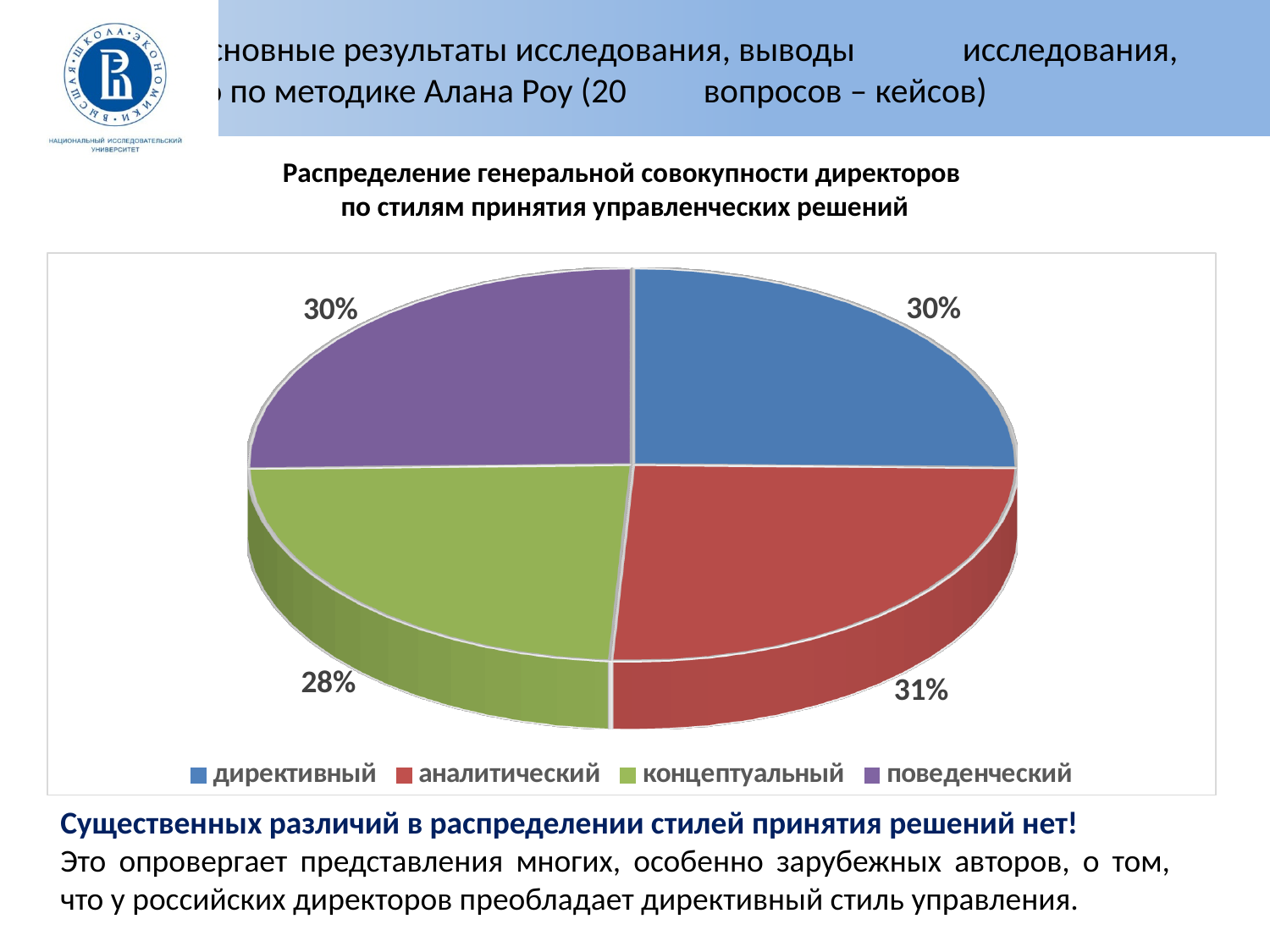
How many slices does the pie chart have? 4 What type of chart is shown on the slide? pie chart Which decision-making style has the smallest share in the pie chart? концептуальный How many entries does the chart legend list? 4 What percentage is shown for the концептуальный style? 28% Which decision-making style has the largest share in the pie chart? аналитический What share of the pie does the поведенческий slice represent? 30% What colour is the аналитический slice in the pie chart? red What share of the pie does the директивный slice represent? 30% What percentage is shown for the аналитический style? 31% Which slice is larger, аналитический or концептуальный? аналитический What is the difference in percentage points between the аналитический and концептуальный slices? 3